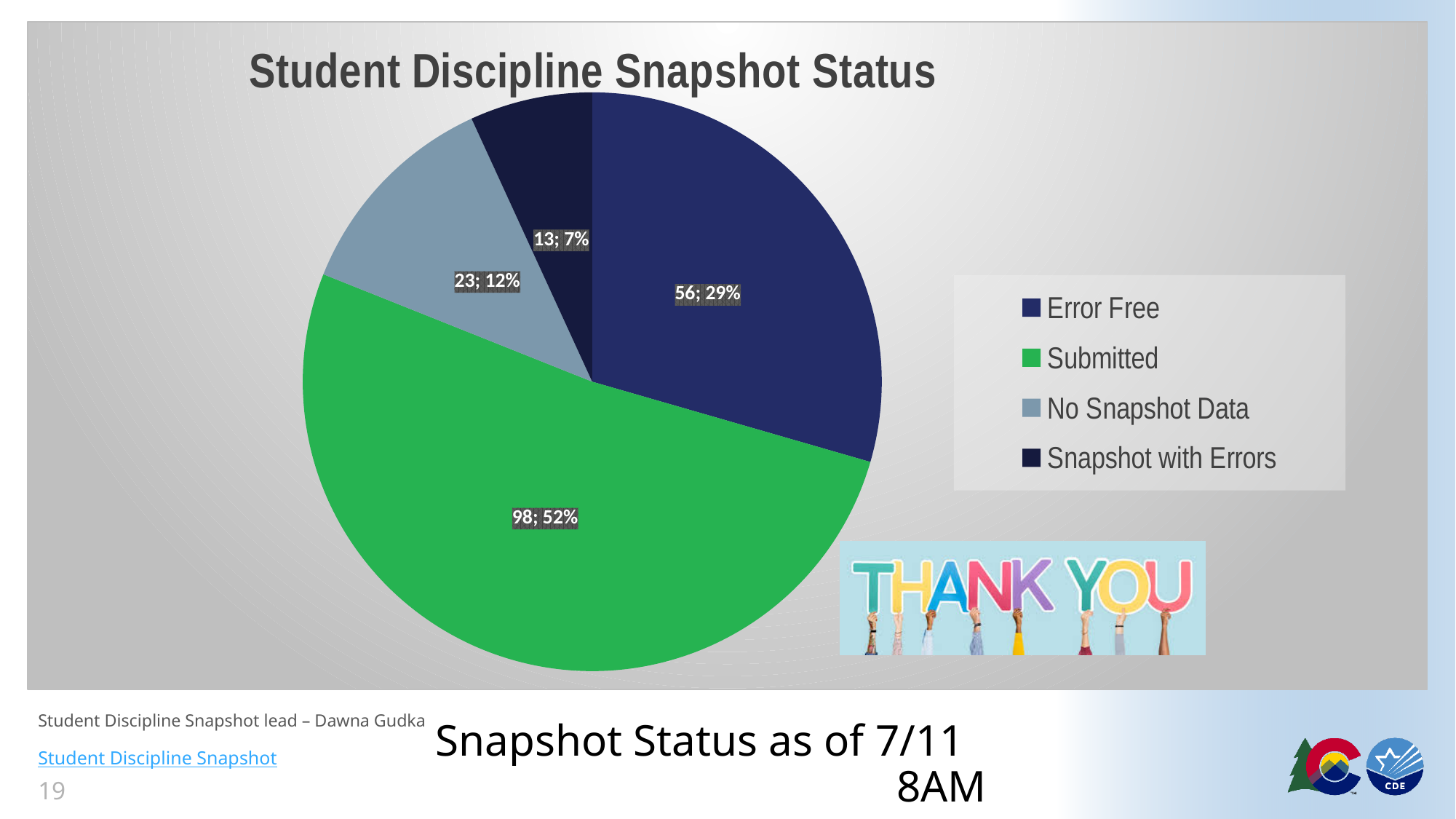
What type of chart is shown on the slide? pie chart What is the count for Submitted? 98 What share of the pie does Submitted represent? 52% What is the count for No Snapshot Data? 23 What is the difference between the counts for Submitted and Error Free? 42 What is the count for Snapshot with Errors? 13 Which category has the smallest slice? Snapshot with Errors Which category has the largest slice? Submitted What is the title of the chart? Student Discipline Snapshot Status What is the count for Error Free? 56 What share of the pie does Error Free represent? 29% How many categories does the legend list? 4